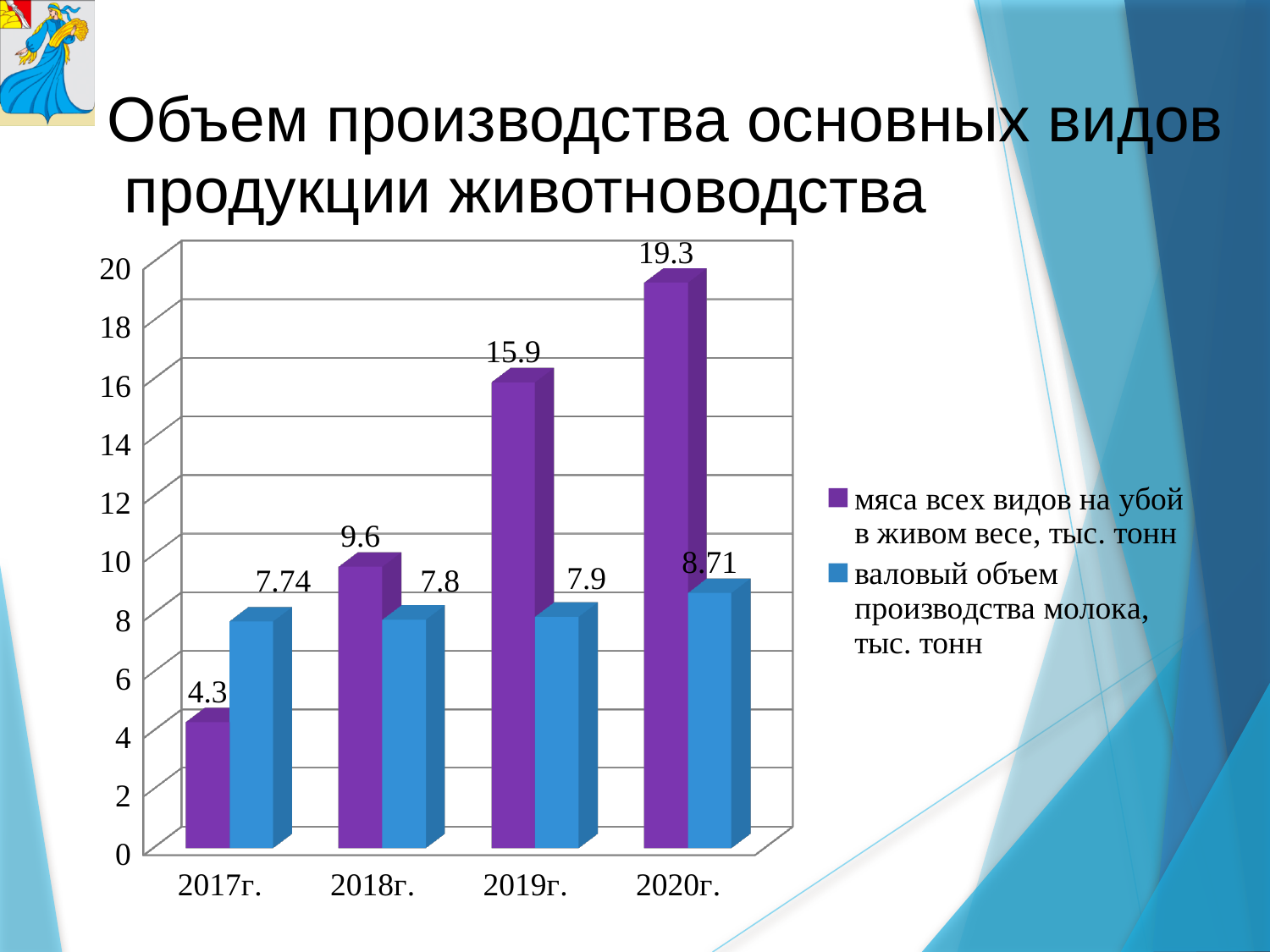
What is the difference between meat production and milk production in 2019г.? 8 In which year is the meat production value the lowest? 2017г. By how much did meat production increase from 2017г. to 2020г.? 15 Does meat production rise or fall from 2017г. to 2020г.? rise What kind of chart is shown on the slide? bar chart What is the gross milk production value in 2020г.? 8.71 In which year is the meat production value the highest? 2020г. How many years are shown on the x axis? 4 What is the value for meat of all kinds for slaughter in live weight (мяса всех видов на убой в живом весе) in 2019г.? 15.9 Which is larger in 2017г.: meat production or milk production? milk production (валовый объем производства молока) What is the gross milk production (валовый объем производства молока) value in 2017г.? 7.74 How many series does the legend list? 2